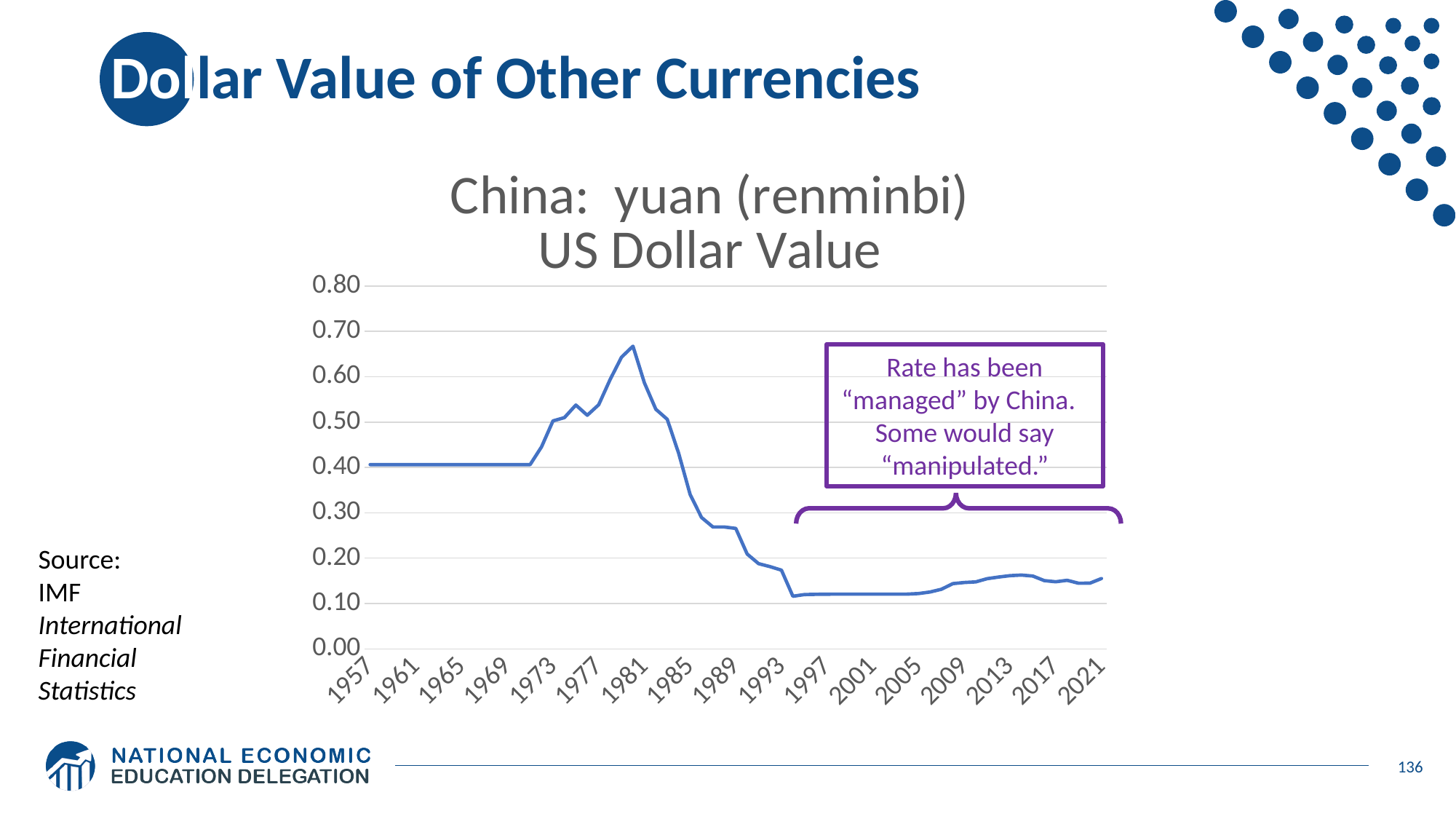
Is the value for 1993 greater or less than 0.30? less Which year has the larger value, 1981 or 2021? 1981 Is the value for 1997 greater or less than 0.20? less What kind of chart is shown on the slide? line chart What is the title of the chart? China: yuan (renminbi) US Dollar Value How many year labels are shown on the x axis? 17 Is the value for 1957 greater or less than 0.50? less Do the values rise or fall between 1981 and 1993? fall Do the values rise or fall between 1969 and 1981? rise Which year has the larger value, 1957 or 2001? 1957